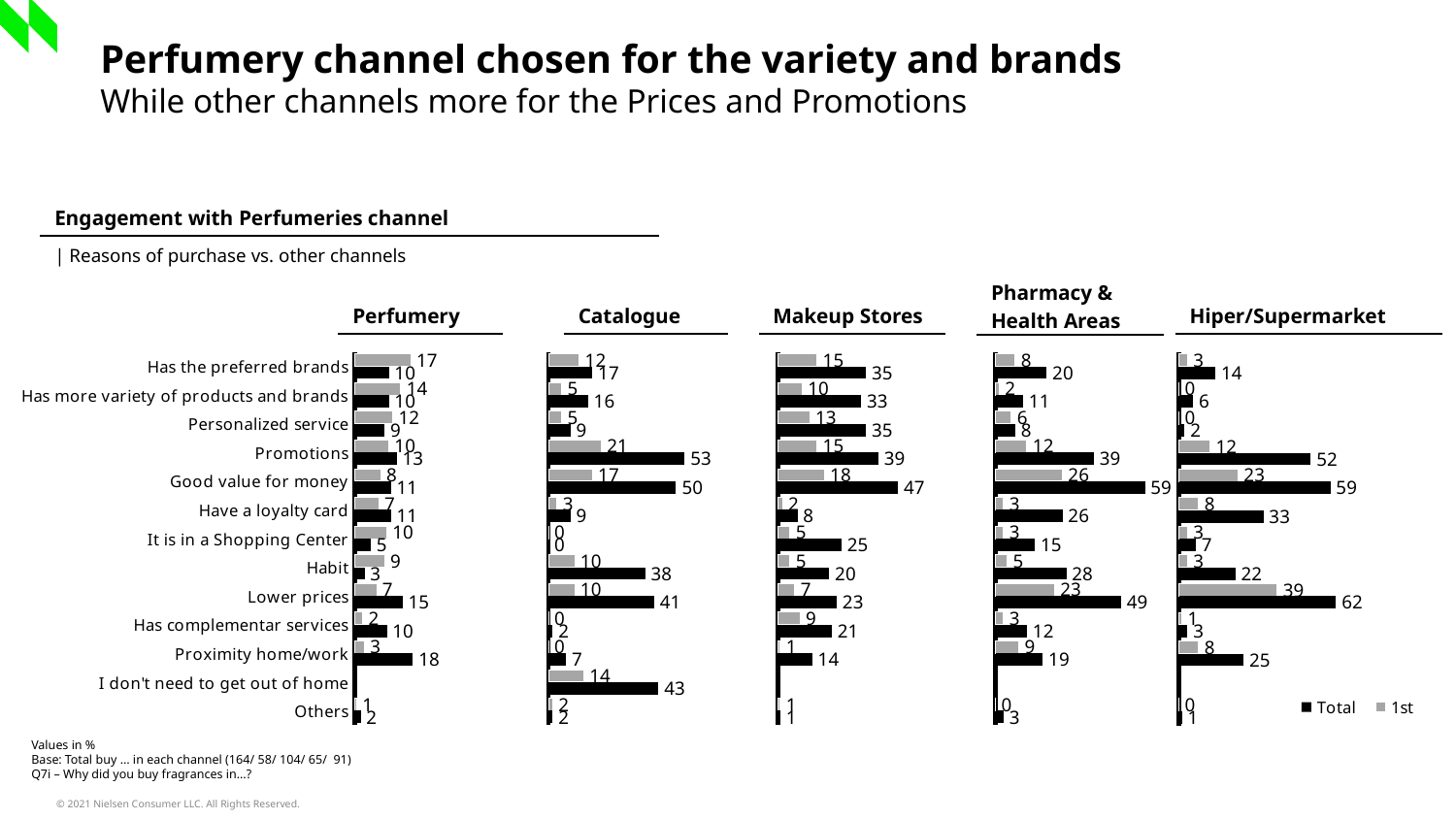
In the Catalogue chart, what is the Total value for Promotions? 53 In the Hiper/Supermarket chart, what is the Total value for Lower prices? 62 In the Perfumery chart, which reason has the highest Total value? Proximity home/work In the Pharmacy & Health Areas chart, what is the 1st value for Lower prices? 23 In the Makeup Stores chart, what is the Total value for Has the preferred brands? 35 In the Pharmacy & Health Areas chart, which reason has the highest Total value? Good value for money In the Catalogue chart, what is the difference between the Total and 1st values for I don't need to get out of home? 29 In the Perfumery chart, what is the 1st value for Has the preferred brands? 17 How many series does the legend list? 2 In the Hiper/Supermarket chart, which is larger for Good value for money: the Total value or the 1st value? Total In the Makeup Stores chart, which reason has the highest Total value? Good value for money What kind of chart is used for each channel on the slide? Bar chart